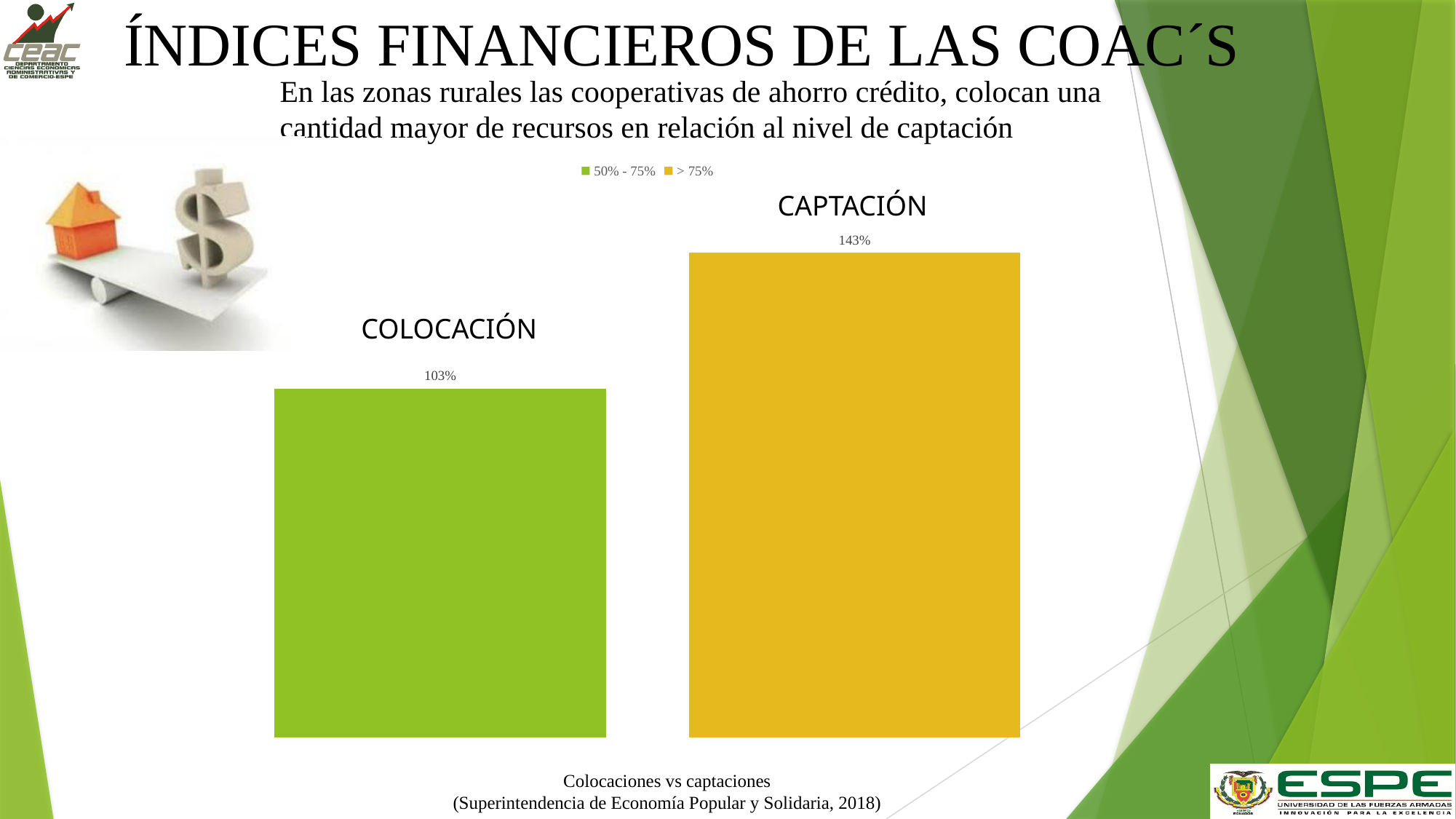
How many entries does the legend list? 2 What colour is the CAPTACIÓN bar? Yellow Which category has the highest value? CAPTACIÓN What are the two entries listed in the chart legend? 50% - 75% and > 75% What kind of chart is shown on the slide? Bar chart How many bars are plotted in the chart? 2 Which category has the lowest value? COLOCACIÓN What value is shown for COLOCACIÓN? 103% What value is shown for CAPTACIÓN? 143% Which is larger, the value for COLOCACIÓN or the value for CAPTACIÓN? CAPTACIÓN What is the difference between the CAPTACIÓN value and the COLOCACIÓN value? 40%